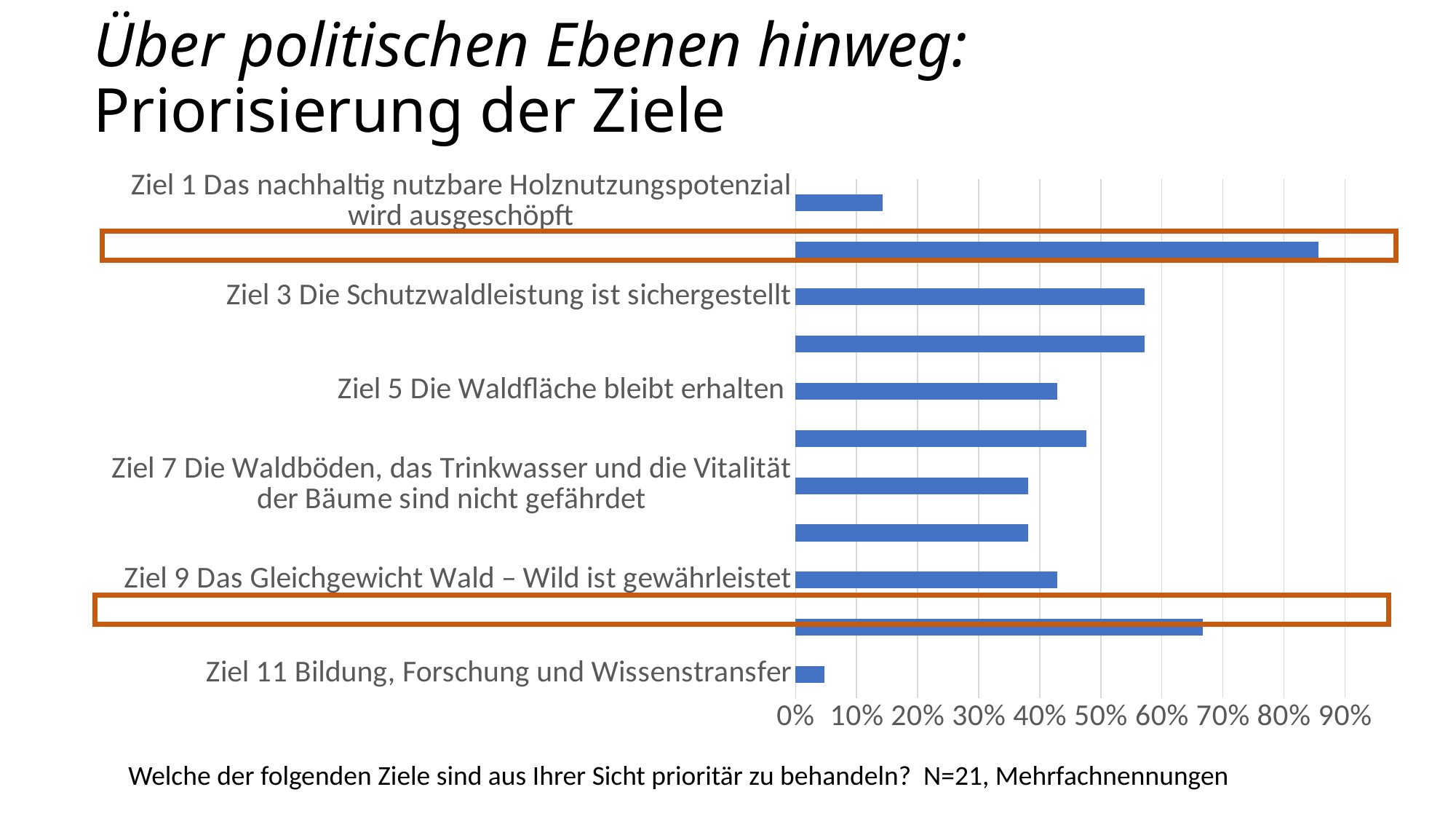
Is the value for Ziel 1 Das nachhaltig nutzbare Holznutzungspotenzial wird ausgeschöpft greater or less than 20%? less What kind of chart is shown on the slide? bar chart How many bars does the chart contain? 11 Which has the larger value: Ziel 3 Die Schutzwaldleistung ist sichergestellt or Ziel 5 Die Waldfläche bleibt erhalten? Ziel 3 Die Schutzwaldleistung ist sichergestellt What is the highest tick label shown on the horizontal axis of the chart? 90% Is the value for Ziel 11 Bildung, Forschung und Wissenstransfer greater or less than 10%? less Which has the larger value: Ziel 1 Das nachhaltig nutzbare Holznutzungspotenzial wird ausgeschöpft or Ziel 11 Bildung, Forschung und Wissenstransfer? Ziel 1 Das nachhaltig nutzbare Holznutzungspotenzial wird ausgeschöpft Is the value for Ziel 3 Die Schutzwaldleistung ist sichergestellt greater or less than 50%? greater Among the categories whose labels are shown, which has the highest value? Ziel 3 Die Schutzwaldleistung ist sichergestellt Which category has the lowest value in the chart? Ziel 11 Bildung, Forschung und Wissenstransfer